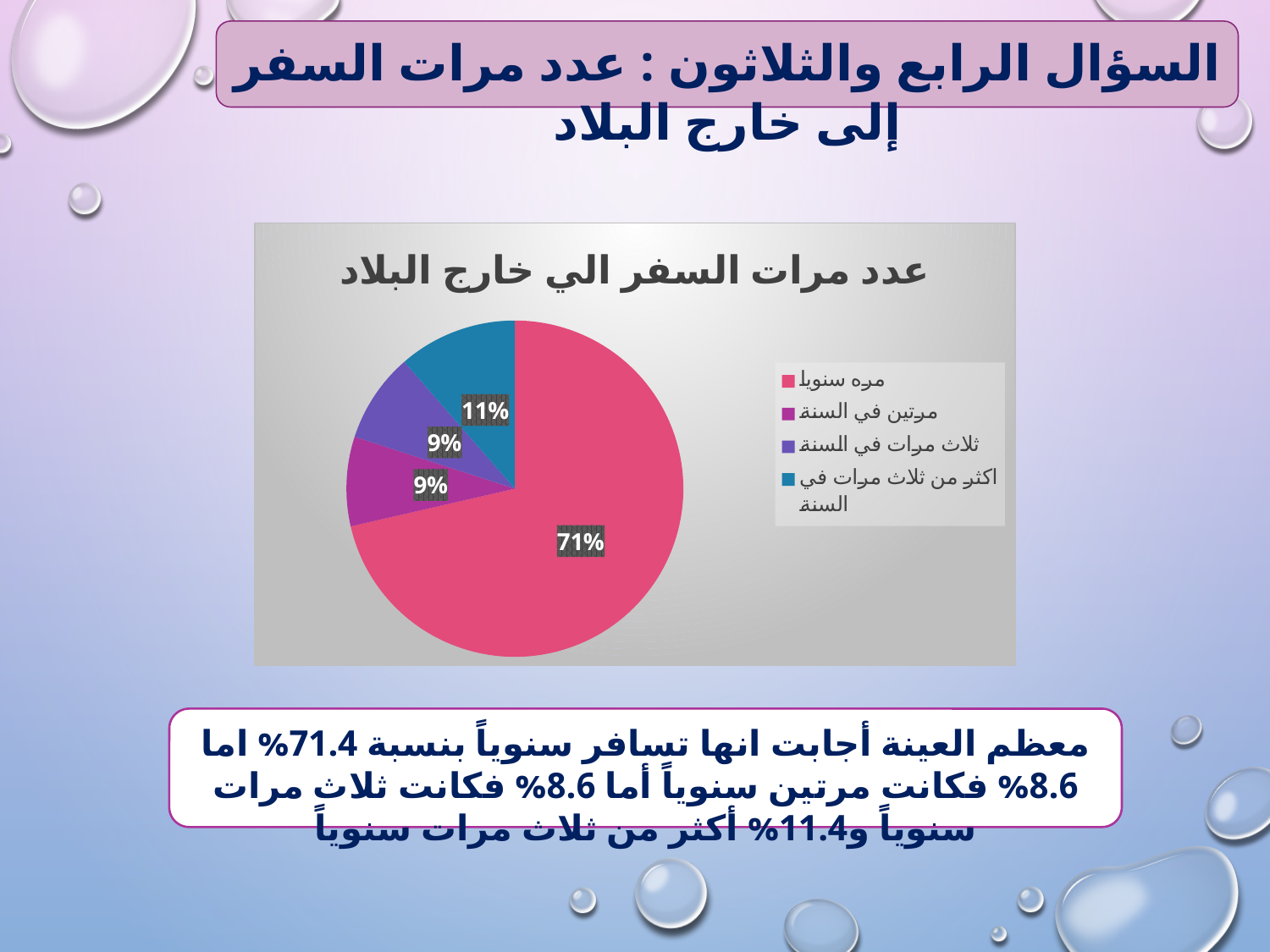
What is the title of the chart? عدد مرات السفر الي خارج البلاد Which is larger: the slice for اكثر من ثلاث مرات في السنة or the slice for مرتين في السنة? اكثر من ثلاث مرات في السنة What percentage is shown for مرتين في السنة? 9% What is the difference in percentage points between the مره سنويا slice and the اكثر من ثلاث مرات في السنة slice? 60% What percentage of the pie is labelled for مره سنويا? 71% What percentage is shown for ثلاث مرات في السنة? 9% How many entries does the legend list? 4 What percentage is shown for اكثر من ثلاث مرات في السنة? 11% What type of chart is shown on the slide? Pie chart What colour is the slice for مره سنويا? Pink How many slices does the pie chart have? 4 Which category has the largest slice of the pie? مره سنويا